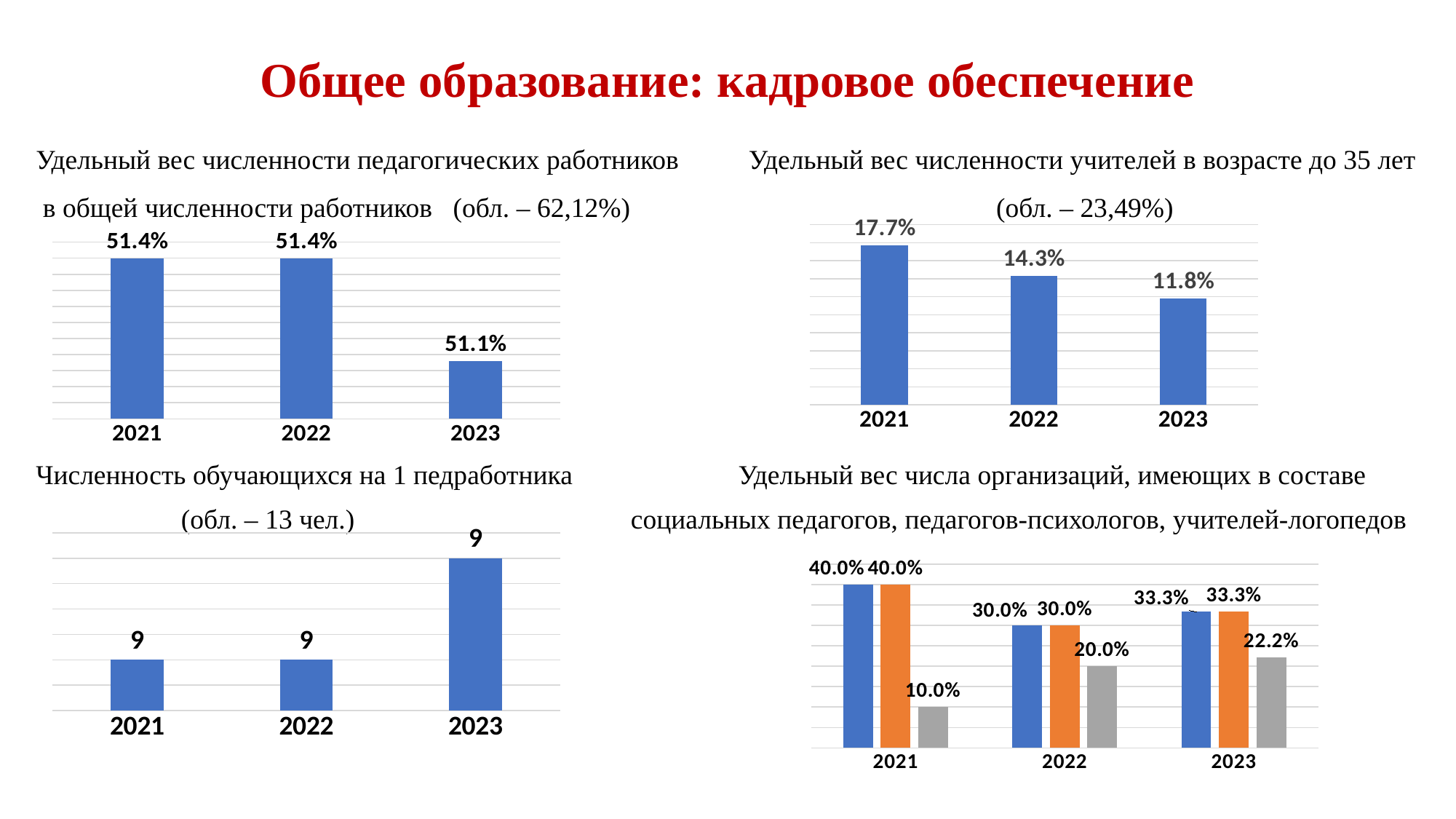
In the top-right chart (Удельный вес численности учителей в возрасте до 35 лет), which year has the highest value? 2021 In the top-left chart (Удельный вес численности педагогических работников в общей численности работников), which year has the lowest value? 2023 In the bottom-right chart (Удельный вес числа организаций, имеющих в составе социальных педагогов, педагогов-психологов, учителей-логопедов), what is the value of the grey bar for 2023? 22.2% In the top-right chart (Удельный вес численности учителей в возрасте до 35 лет), do the values rise or fall from 2021 to 2023? fall In the bottom-right chart (Удельный вес числа организаций, имеющих в составе социальных педагогов, педагогов-психологов, учителей-логопедов), which is larger: the blue bar for 2021 or the blue bar for 2022? 2021 In the top-right chart (Удельный вес численности учителей в возрасте до 35 лет), what is the value for 2022? 14.3% In the top-right chart (Удельный вес численности учителей в возрасте до 35 лет), what is the difference between the 2021 and 2023 values? 5.9% How many years are shown on the x axis of the bottom-left chart (Численность обучающихся на 1 педработника)? 3 In the bottom-left chart (Численность обучающихся на 1 педработника), what is the value for 2021? 9 What type of chart is the top-left chart (Удельный вес численности педагогических работников в общей численности работников)? bar chart In the bottom-right chart (Удельный вес числа организаций, имеющих в составе социальных педагогов, педагогов-психологов, учителей-логопедов), what is the difference between the orange bar and the grey bar for 2022? 10.0% In the top-left chart (Удельный вес численности педагогических работников в общей численности работников), what is the value for 2023? 51.1%